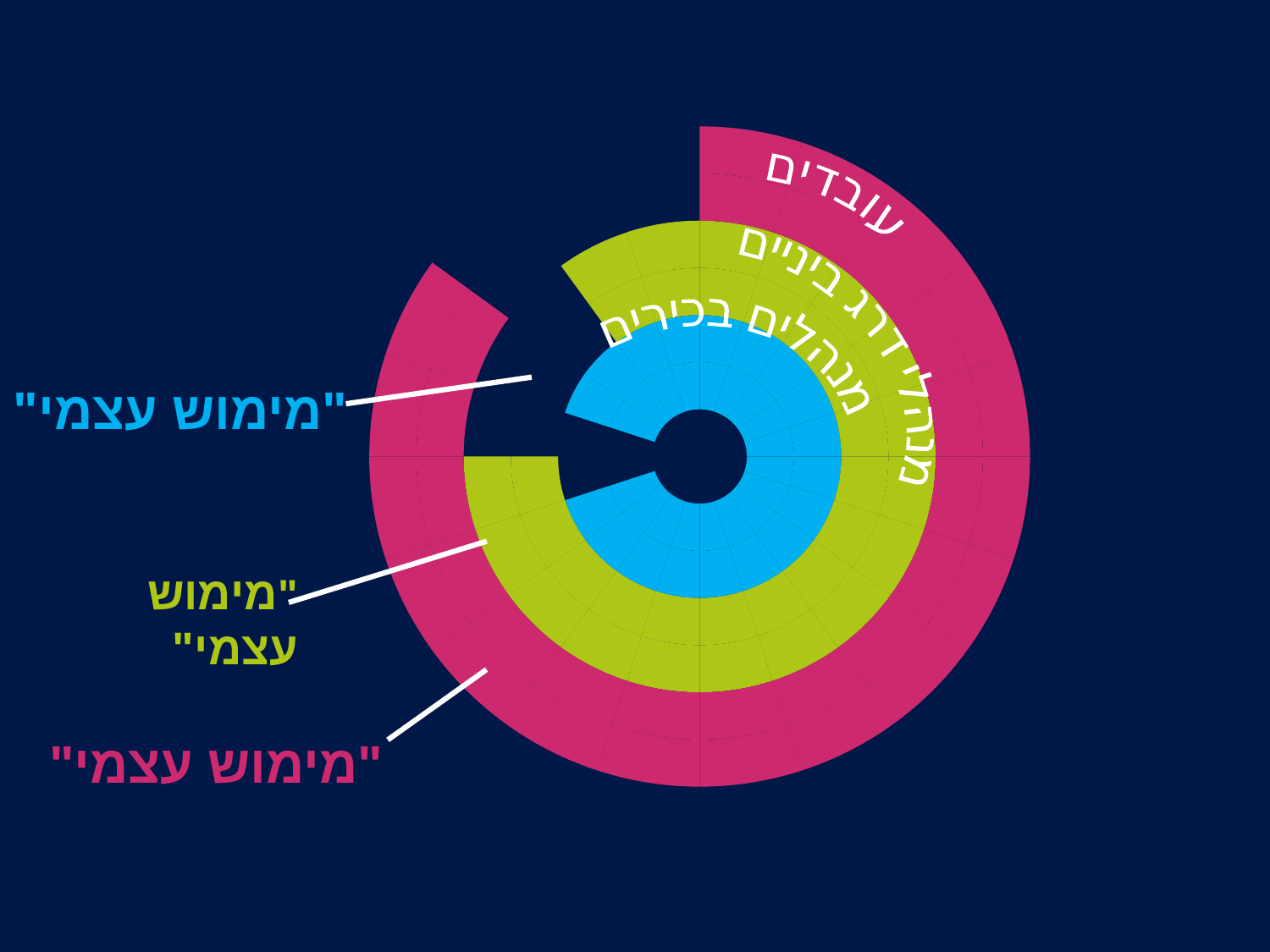
Which group is represented by the outermost magenta ring? עובדים Which group is represented by the innermost blue ring? מנהלים בכירים What label is attached to the gap in each ring? "מימוש עצמי" What colour is the ring for מנהלי דרג ביניים? green